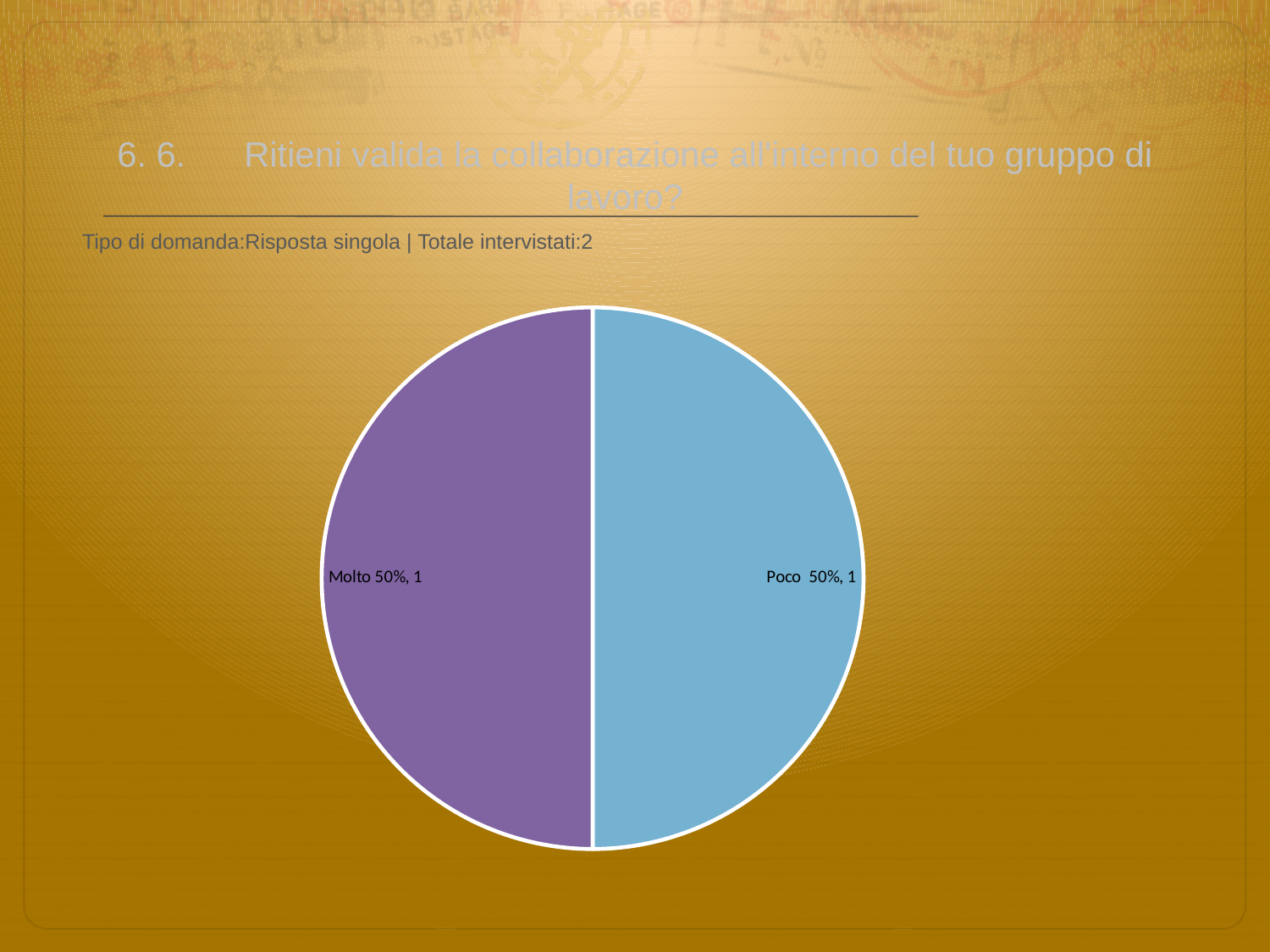
What kind of chart is shown on the slide? pie chart What share of the pie does the Poco slice represent? 50% How many slices does the pie chart have? 2 What colour is the Molto slice? purple What is the total of the values for Molto and Poco? 2 What is the difference between the values for Molto and Poco? 0 What colour is the Poco slice? light blue What is the count value shown for Molto? 1 What is the count value shown for Poco? 1 What share of the pie does the Molto slice represent? 50%